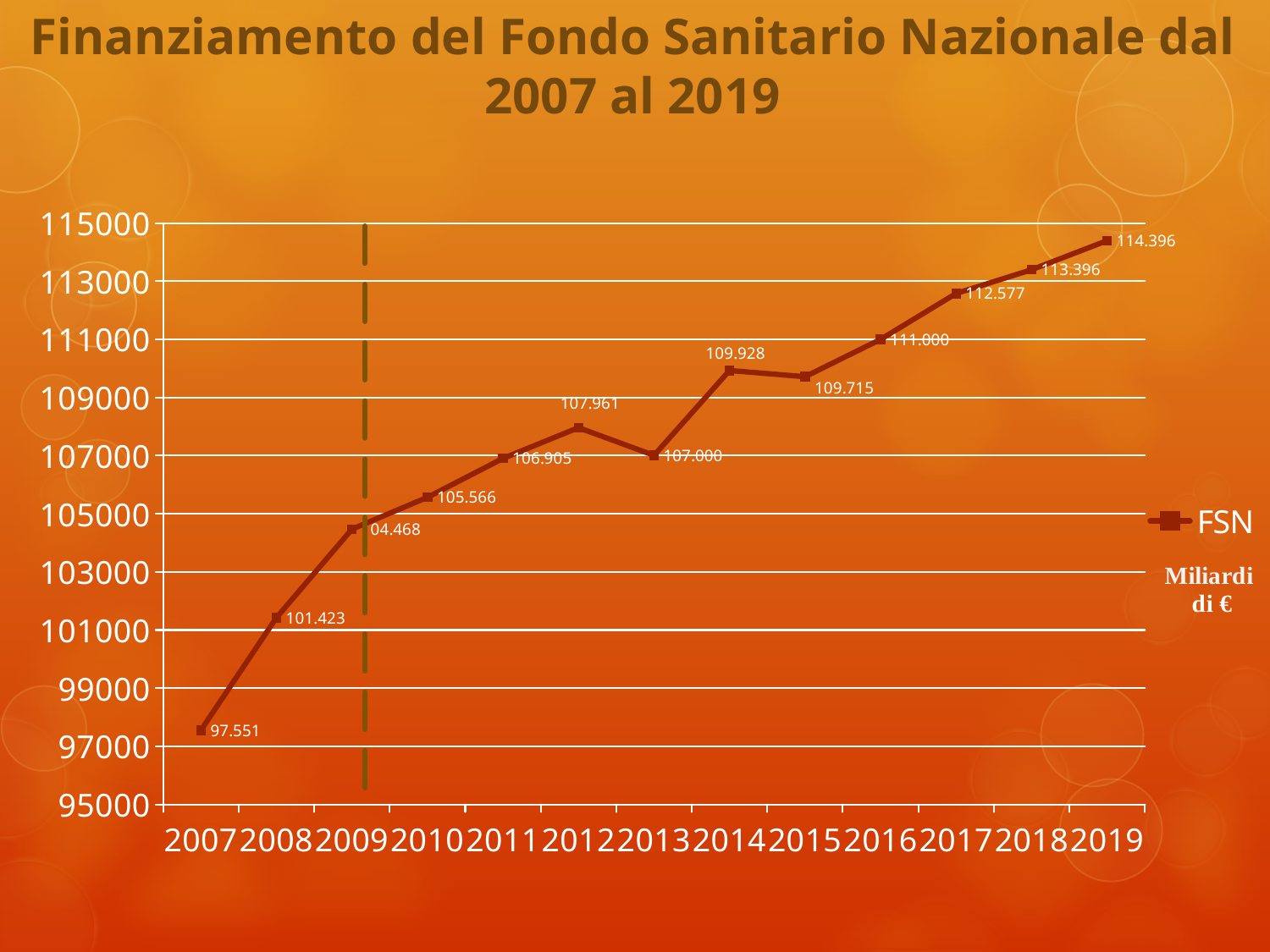
Which is larger, the value for 2012 or the value for 2013? 2012 What is the difference between the values for 2019 and 2007? 16.845 What is the value for 2014? 109.928 Which year has the highest value? 2019 What is the value for 2007? 97.551 What is the value for 2013? 107.000 What is the value for 2019? 114.396 What kind of chart is shown? line chart Is the value for 2016 greater or less than 109000? greater Which year has the lowest value? 2007 What is the name of the series shown in the legend? FSN How many years are plotted on the chart? 13